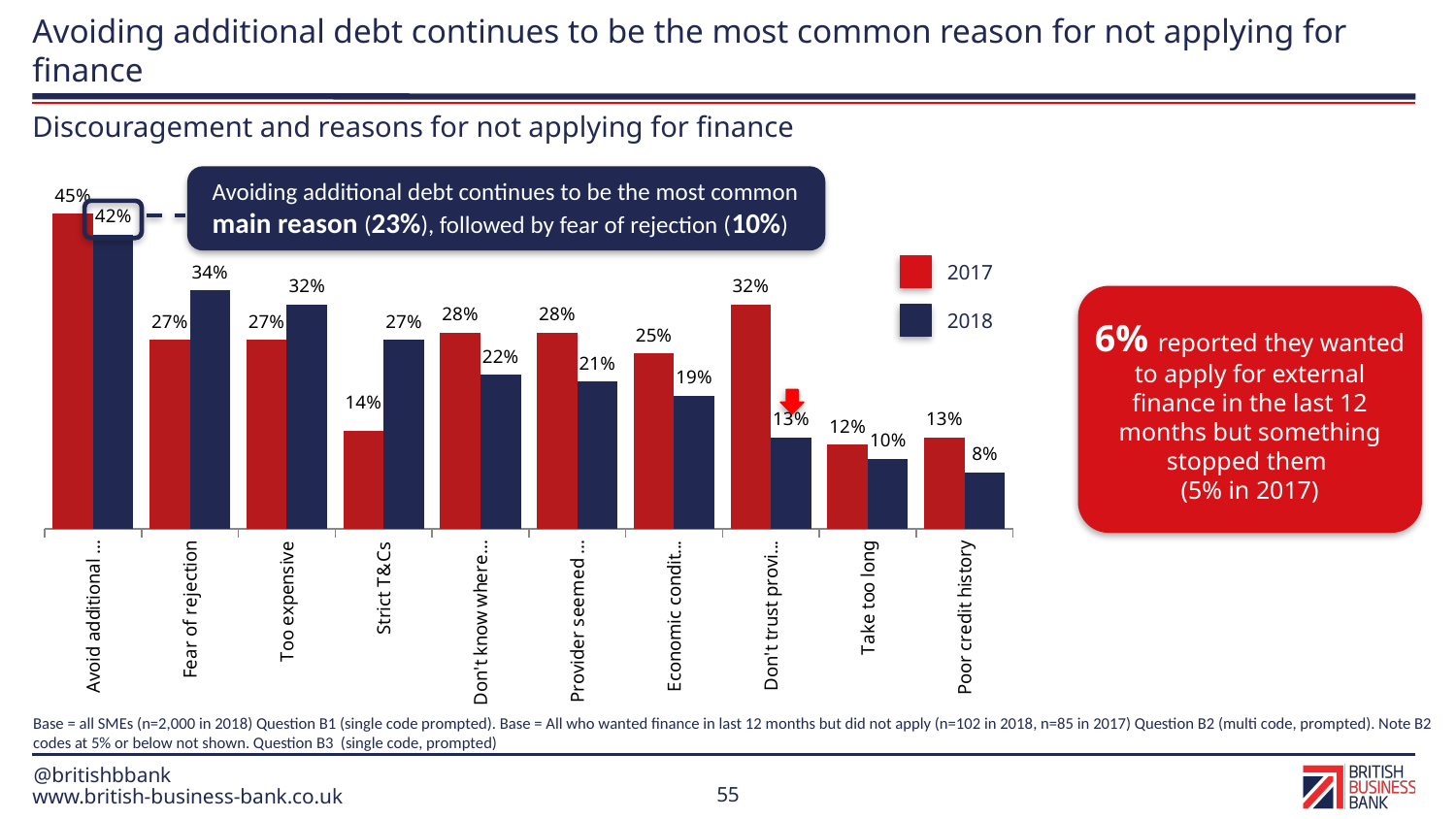
How many series does the legend list? 2 What is the 2018 value for Poor credit history? 8% Which category has the lowest 2018 value? Poor credit history Which category has the lowest 2017 value? Take too long How many categories are shown on the x axis of the chart? 10 What kind of chart is shown on the slide? Bar chart Which is larger for Too expensive, the 2017 value or the 2018 value? 2018 Which colour represents 2018 in the chart? Navy blue What is the difference between the 2018 and 2017 values for Strict T&Cs? 13% What is the 2017 value for Strict T&Cs? 14% What is the 2018 value for Fear of rejection? 34% What is the 2017 value for Too expensive? 27%